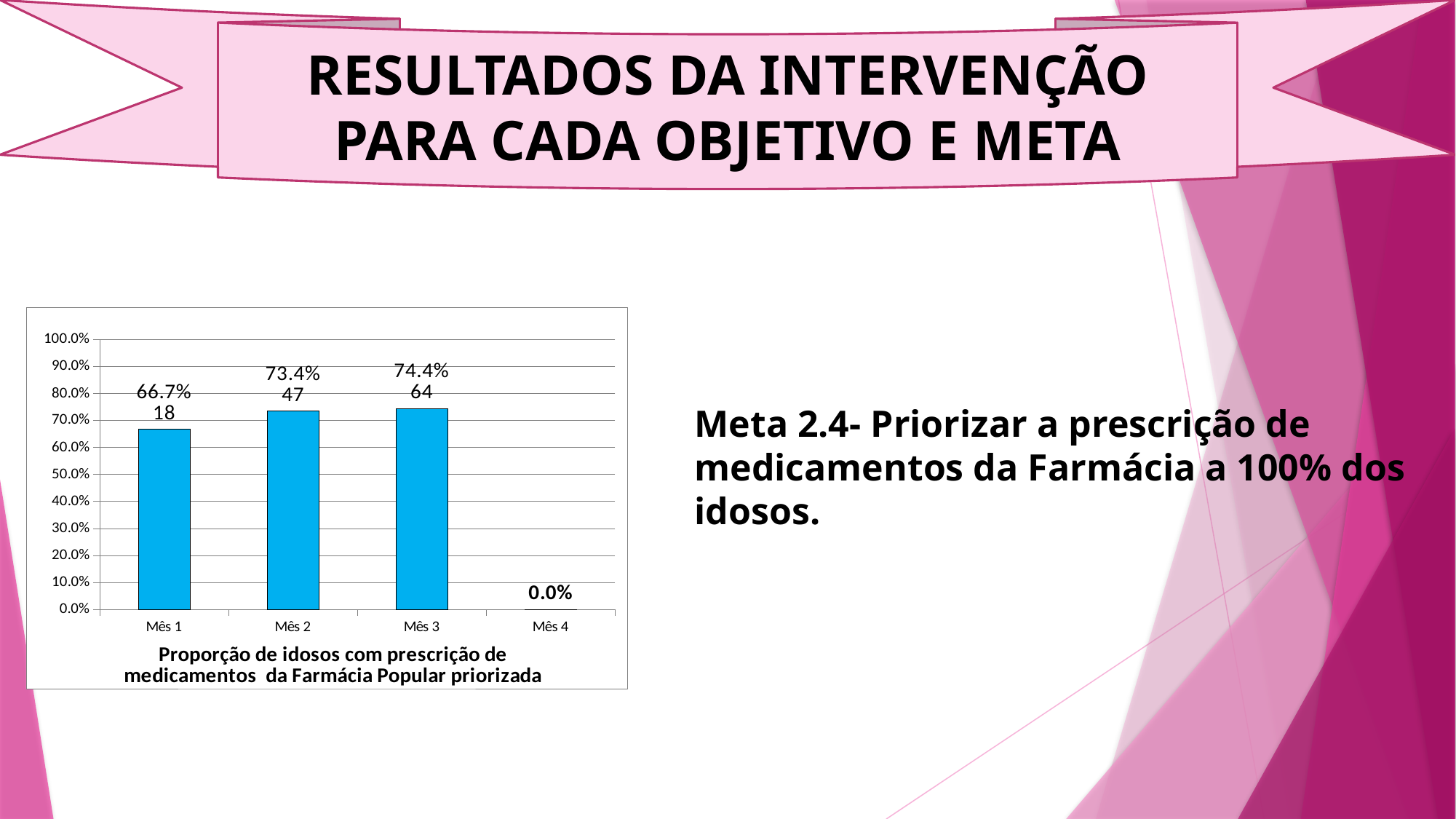
What kind of chart is shown on the slide? Bar chart Which month has the highest percentage value? Mês 3 What is the percentage value shown for Mês 3? 74.4% Which month has the lowest percentage value? Mês 4 What is the percentage value shown for Mês 4? 0.0% What count is printed below the percentage label for Mês 3? 64 Which is larger, the value for Mês 1 or the value for Mês 2? Mês 2 What is the difference in percentage points between Mês 2 and Mês 1? 6.7 How many months (categories) are shown on the x axis? 4 What is the percentage value shown for Mês 1? 66.7% What is the percentage value shown for Mês 2? 73.4% What is the title printed below the chart? Proporção de idosos com prescrição de medicamentos da Farmácia Popular priorizada